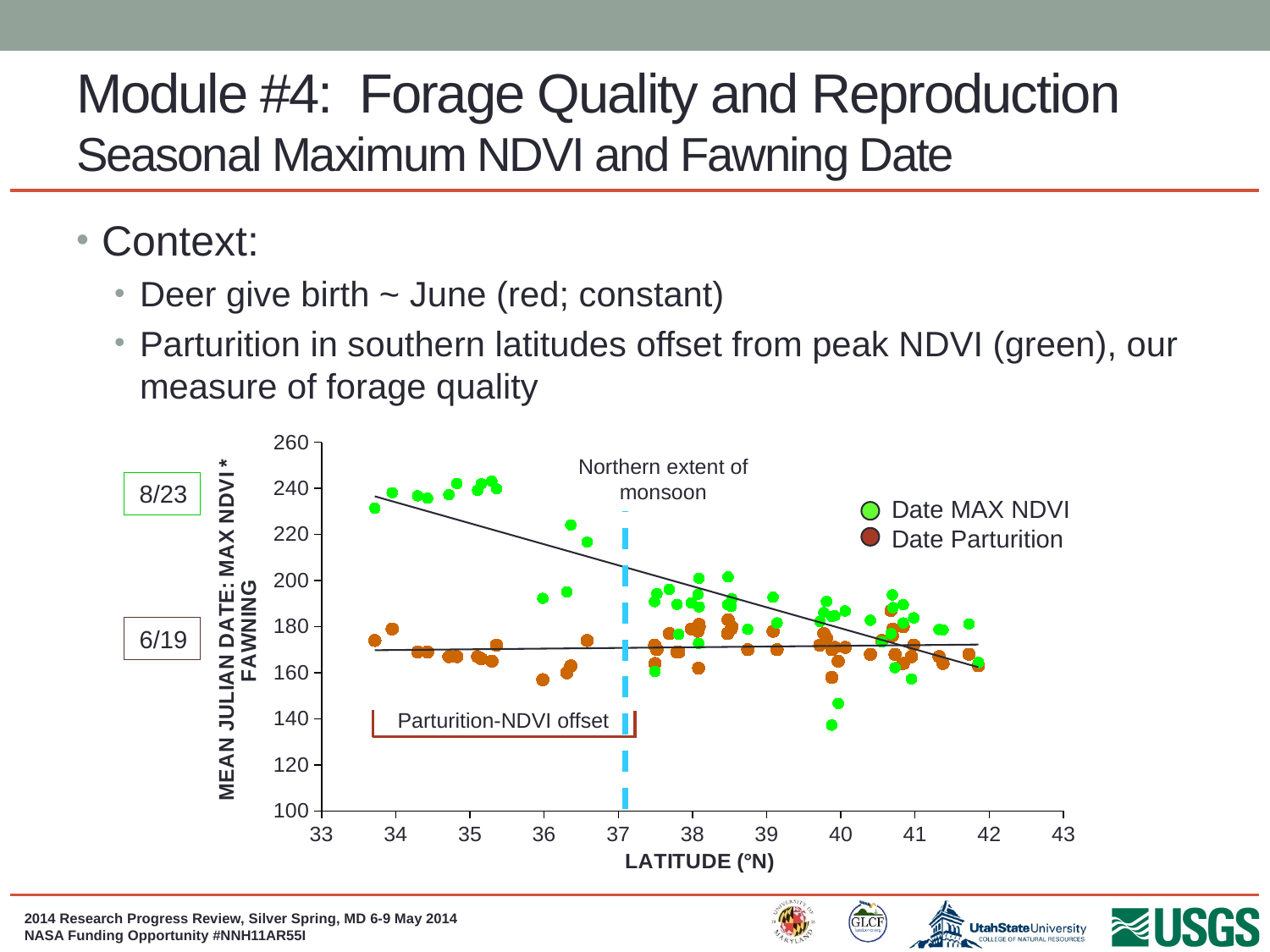
What kind of chart is shown on the slide? scatter chart What are the two series named in the legend? Date MAX NDVI and Date Parturition Is the Date MAX NDVI value at latitude 35 greater or less than 220? greater At latitude 34, which series has the higher values, Date MAX NDVI or Date Parturition? Date MAX NDVI Which series shows a clear decline with increasing latitude? Date MAX NDVI How many series does the legend list? 2 How many tick labels are shown on the latitude axis? 11 Do the Date MAX NDVI values rise or fall as latitude increases? fall Is the Date Parturition value at latitude 36 greater or less than 180? less Is the Date MAX NDVI value at latitude 34 greater or less than 220? greater What is the label of the x axis? LATITUDE (°N)